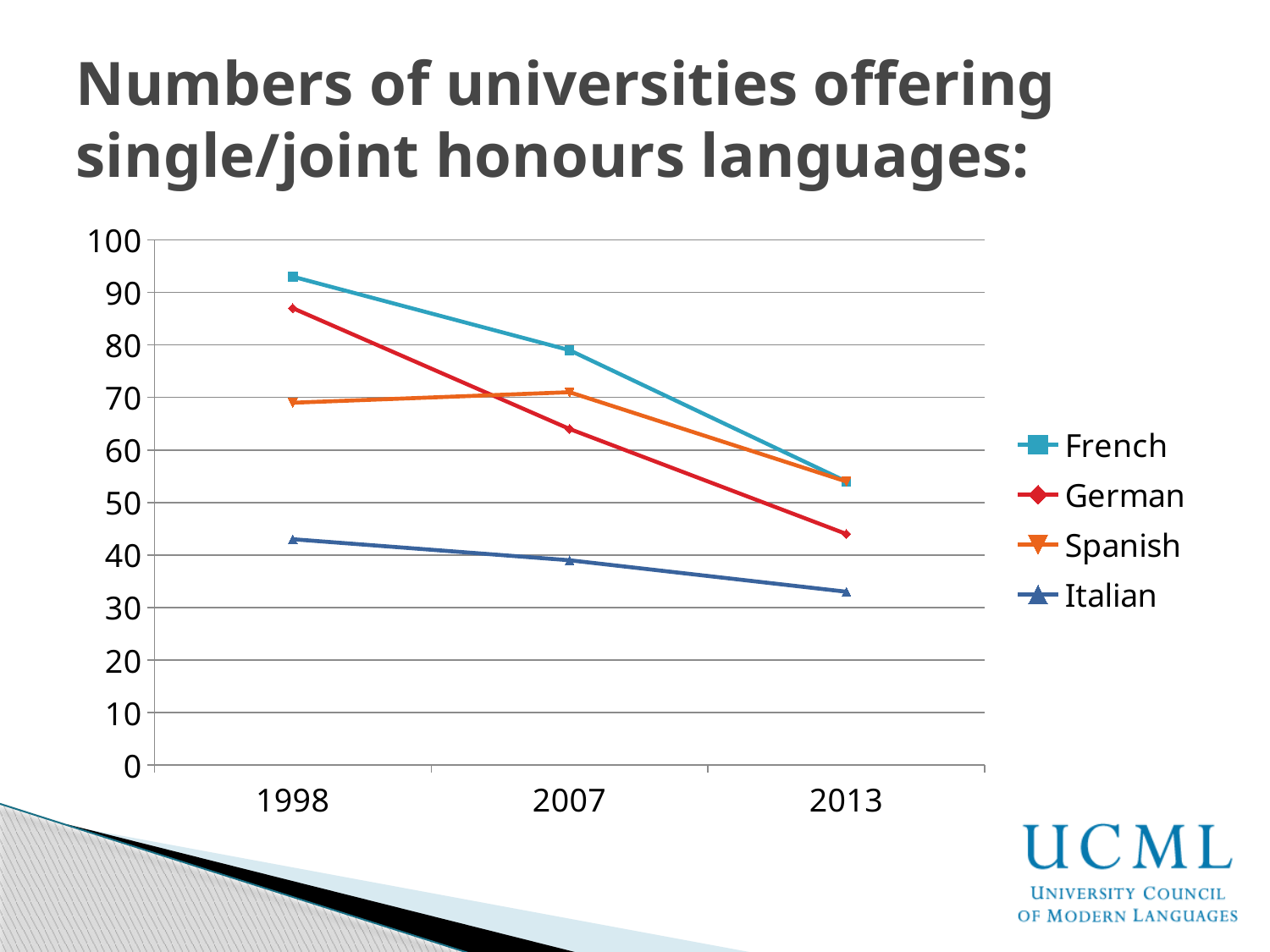
How many series does the legend list? 4 How many years are shown on the x axis? 3 Which language had the highest number of universities in 1998? French What kind of chart is shown on the slide? line chart In 1998, which is larger: the value for German or the value for Spanish? German Is the value for French in 1998 greater or less than 90? greater Does the French line rise or fall from 1998 to 2013? fall Is the value for German in 2013 greater or less than 50? less Which language had the lowest number of universities in 2013? Italian Is the value for Italian in 2013 greater or less than 30? greater In 2007, which is larger: the value for German or the value for Spanish? Spanish Which series is drawn with triangle markers in a dark blue colour? Italian